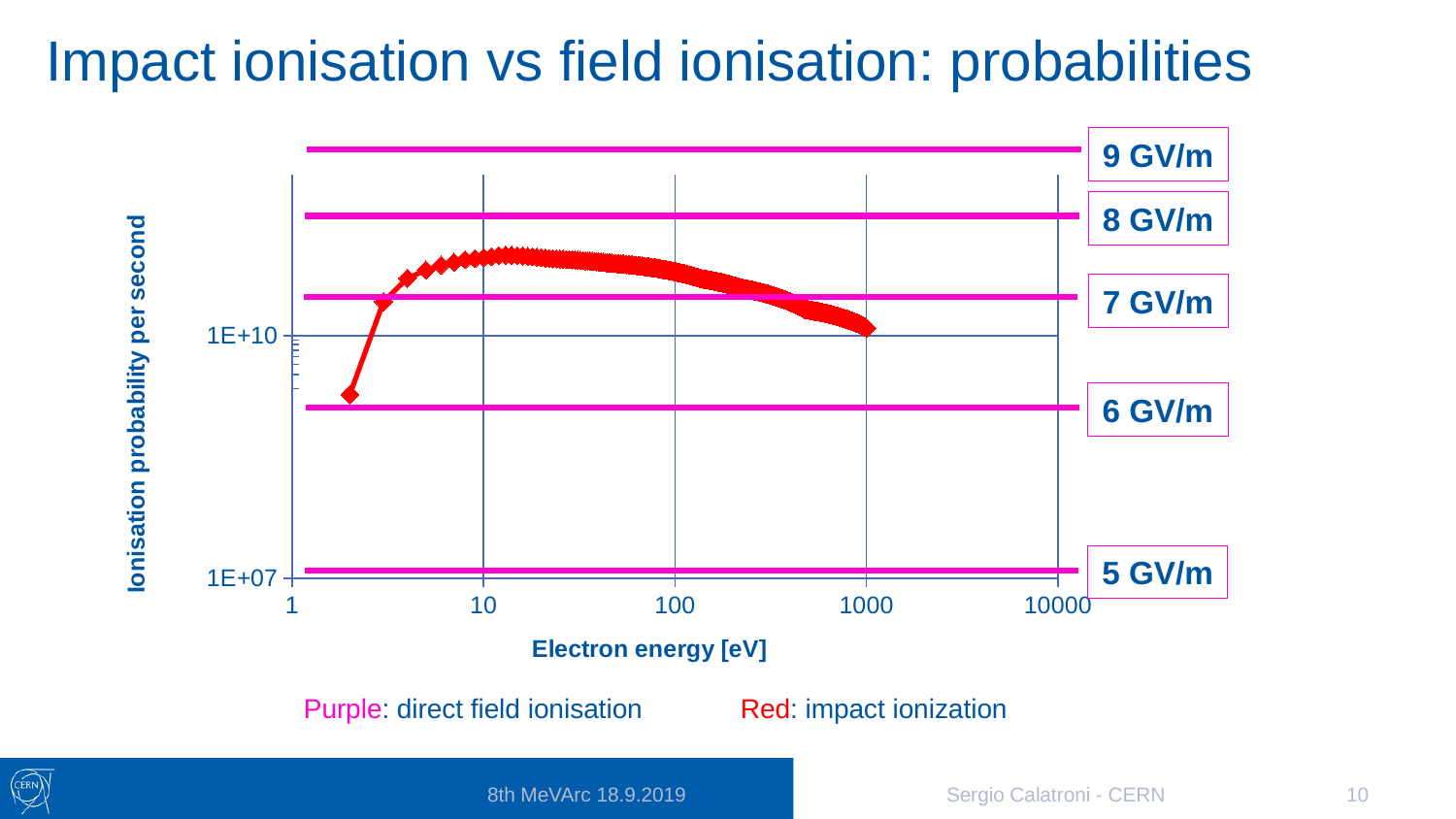
Which field value has the lowest purple line on the chart? 5 GV/m Is the ionisation probability for the 6 GV/m line greater or less than 1E+10? less How many purple horizontal lines (field values) are drawn on the chart? 5 How does the red impact ionization curve behave as electron energy increases along the x axis? rises then falls Is the ionisation probability for the 7 GV/m line greater or less than 1E+10? greater Is the peak of the red impact ionization curve greater or less than 1E+10? greater What does the red curve on the chart represent? impact ionization Which purple line is higher on the chart, 8 GV/m or 7 GV/m? 8 GV/m What is the label of the x axis of the chart? Electron energy [eV] What kind of chart is shown on the slide? line chart Which field value has the highest purple line on the chart? 9 GV/m